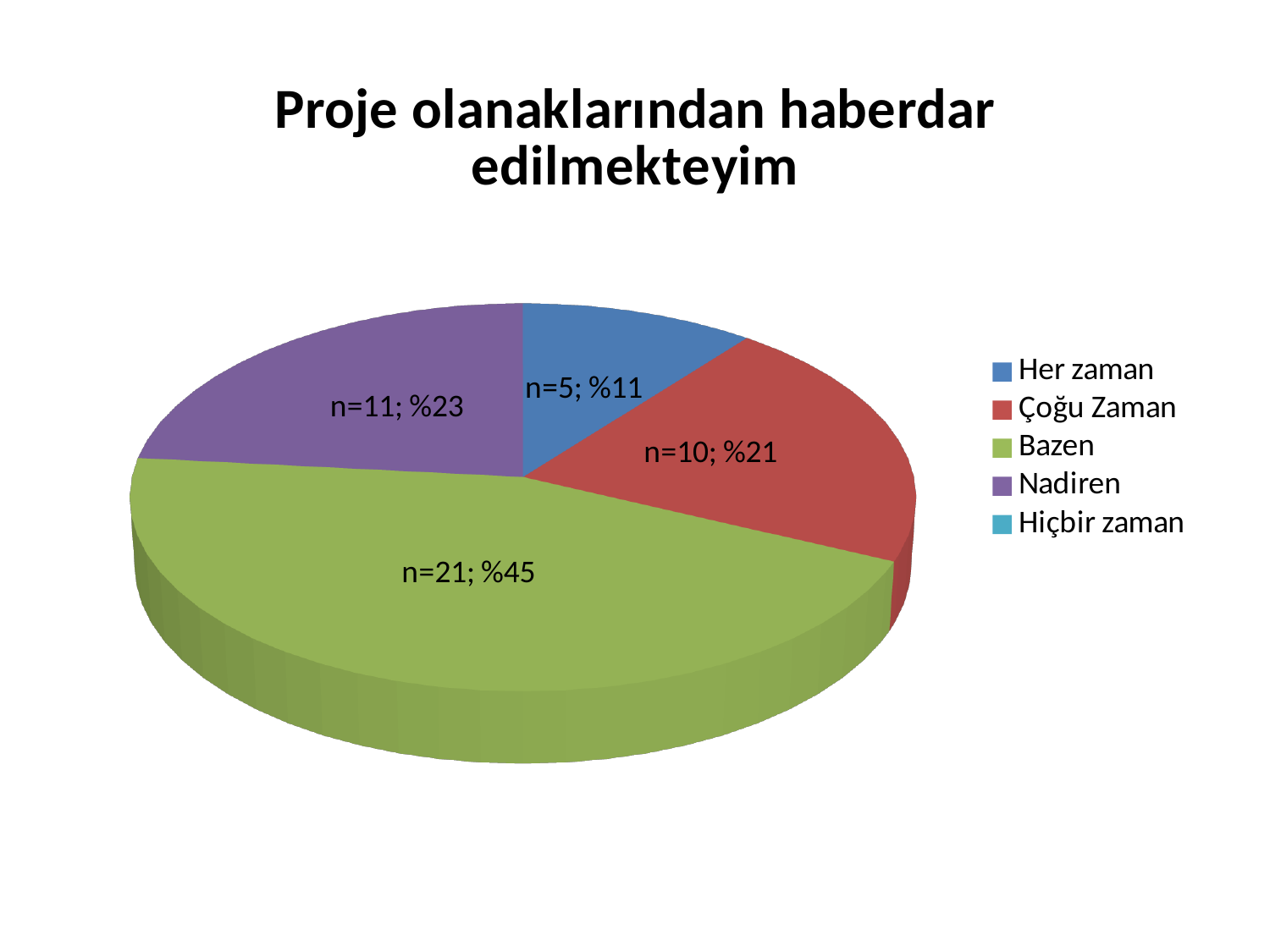
Which labelled slice has the smallest share of the pie? Her zaman What percentage is shown for the Nadiren slice? %23 Which slice is larger, Nadiren or Çoğu Zaman? Nadiren Which category has the largest slice of the pie? Bazen What is the count (n) for the Her zaman slice? 5 What is the difference in count (n) between the Bazen and Çoğu Zaman slices? 11 What is the data label shown for the Bazen slice? n=21; %45 What is the title of the chart? Proje olanaklarından haberdar edilmekteyim Which colour represents the Bazen category in the legend? green What percentage is shown for the Çoğu Zaman slice? %21 What kind of chart is shown on the slide? pie chart How many entries does the legend list? 5